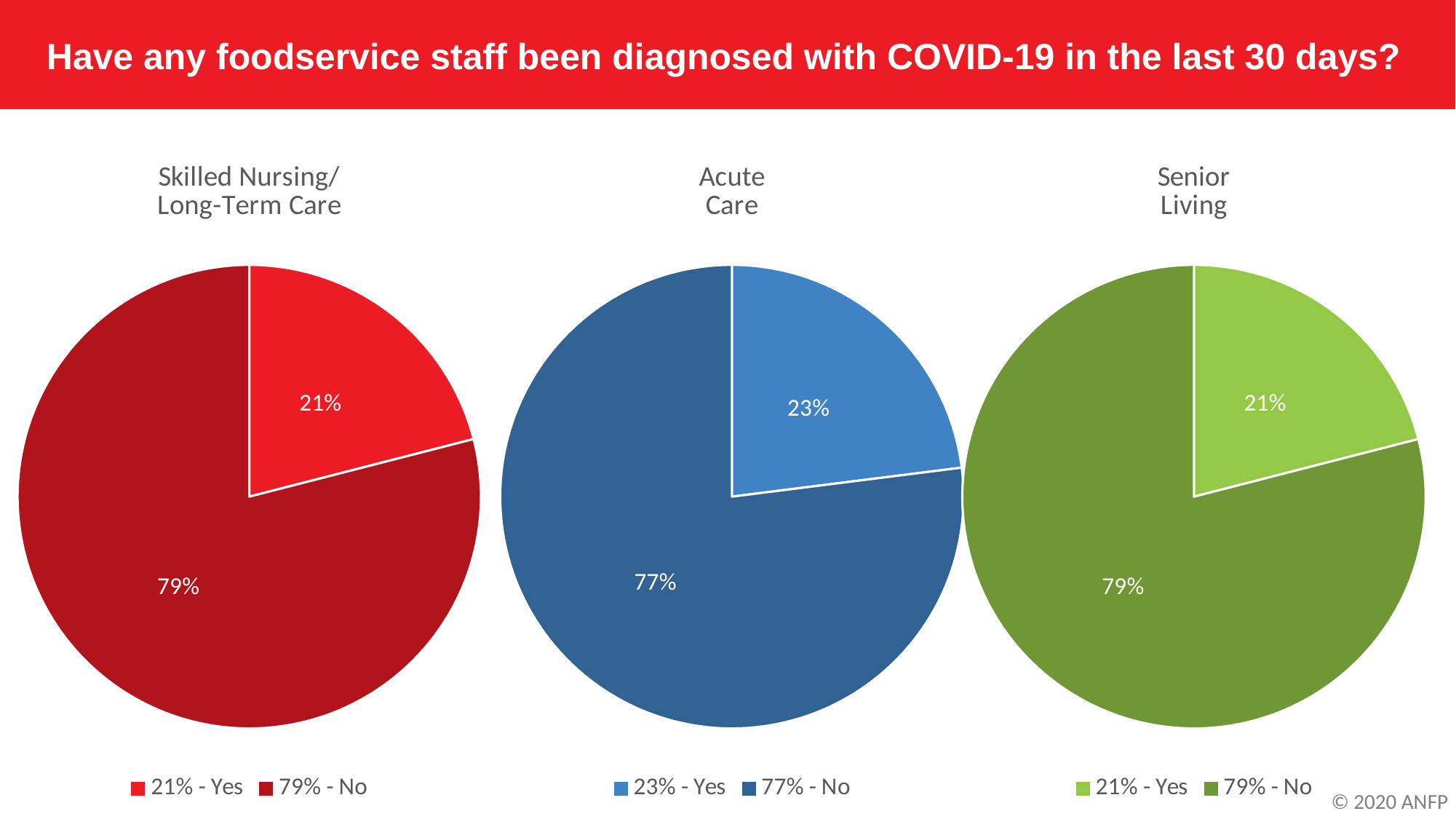
In the Acute Care pie chart, what percentage answered Yes? 23% In the Acute Care pie chart, what percentage answered No? 77% In the Senior Living pie chart, which response has the smallest slice? Yes In the Skilled Nursing/Long-Term Care pie chart, which response has the largest slice? No How many entries does the legend of the Senior Living chart list? 2 Is the Yes share larger in the Acute Care pie chart or the Senior Living pie chart? Acute Care What colour is the Yes slice in the Acute Care pie chart? Light blue In the Acute Care pie chart, what is the difference between the No and Yes percentages? 54% What type of chart is used for Skilled Nursing/Long-Term Care? Pie chart How many slices does the Acute Care pie chart have? 2 In the Senior Living pie chart, what percentage answered Yes? 21% In the Skilled Nursing/Long-Term Care pie chart, what percentage answered Yes? 21%